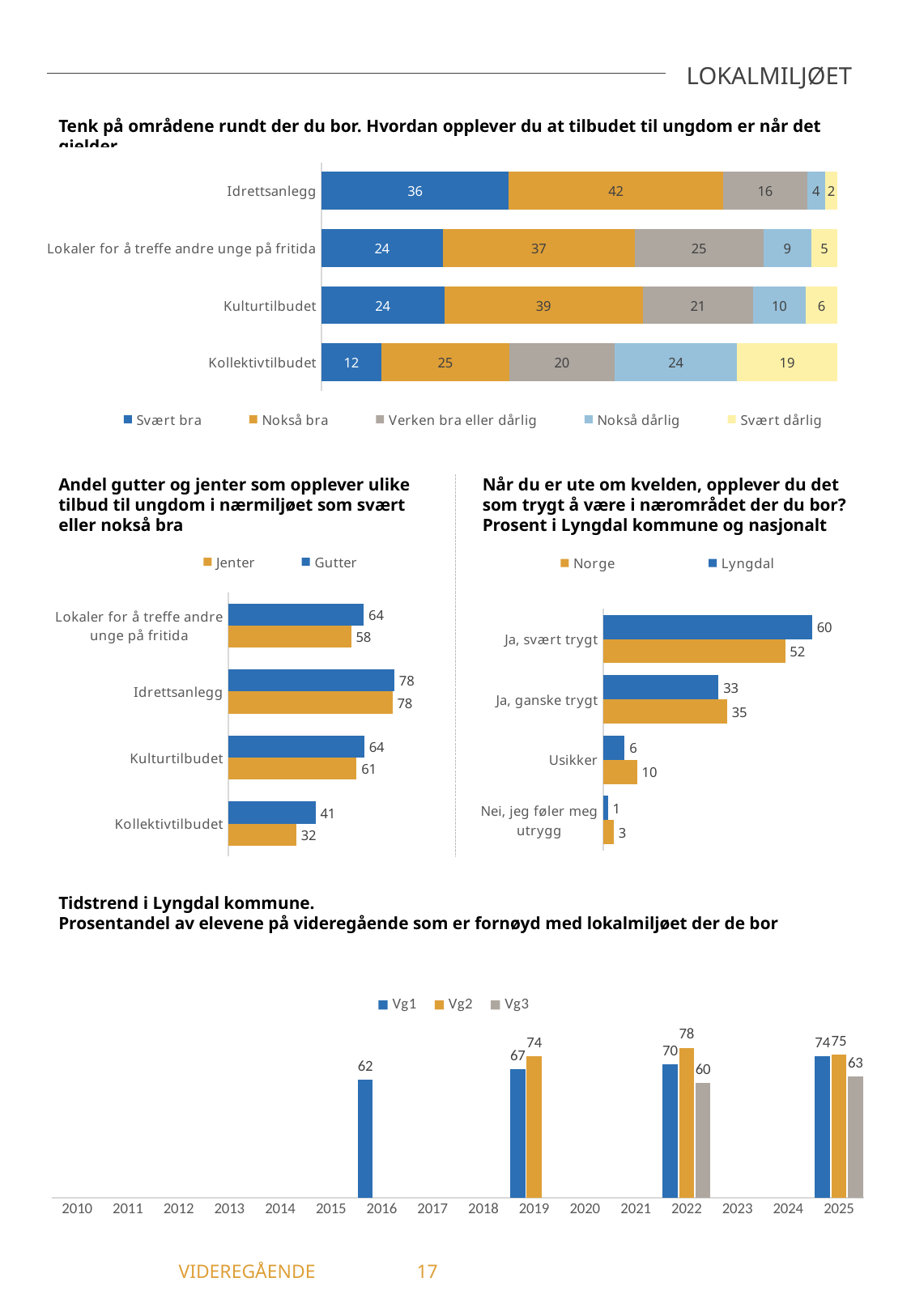
In the chart "Andel gutter og jenter som opplever ulike tilbud til ungdom i nærmiljøet som svært eller nokså bra", what is the value for Jenter for Kollektivtilbudet? 32 In the top stacked bar chart ("Tenk på områdene rundt der du bor..."), which category has the lowest "Svært bra" value? Kollektivtilbudet In the top stacked bar chart ("Tenk på områdene rundt der du bor..."), how many series does the legend list? 5 In the chart "Når du er ute om kvelden, opplever du det som trygt å være i nærområdet der du bor?", which is larger for "Usikker": Norge or Lyngdal? Norge In the chart "Andel gutter og jenter som opplever ulike tilbud til ungdom i nærmiljøet som svært eller nokså bra", how many categories are shown? 4 In the chart "Tidstrend i Lyngdal kommune", what kind of chart is it? Bar chart In the chart "Andel gutter og jenter som opplever ulike tilbud til ungdom i nærmiljøet som svært eller nokså bra", what is the difference between Gutter and Jenter for Kollektivtilbudet? 9 In the top stacked bar chart ("Tenk på områdene rundt der du bor..."), what is the value for "Svært bra" for Idrettsanlegg? 36 In the chart "Tidstrend i Lyngdal kommune", does the Vg1 value rise or fall from 2016 to 2025? Rise In the top stacked bar chart ("Tenk på områdene rundt der du bor..."), what is the value for "Svært dårlig" for Kollektivtilbudet? 19 In the chart "Når du er ute om kvelden, opplever du det som trygt å være i nærområdet der du bor?", what is the value for Lyngdal for "Ja, svært trygt"? 60 In the chart "Tidstrend i Lyngdal kommune", what is the value for Vg2 in 2022? 78